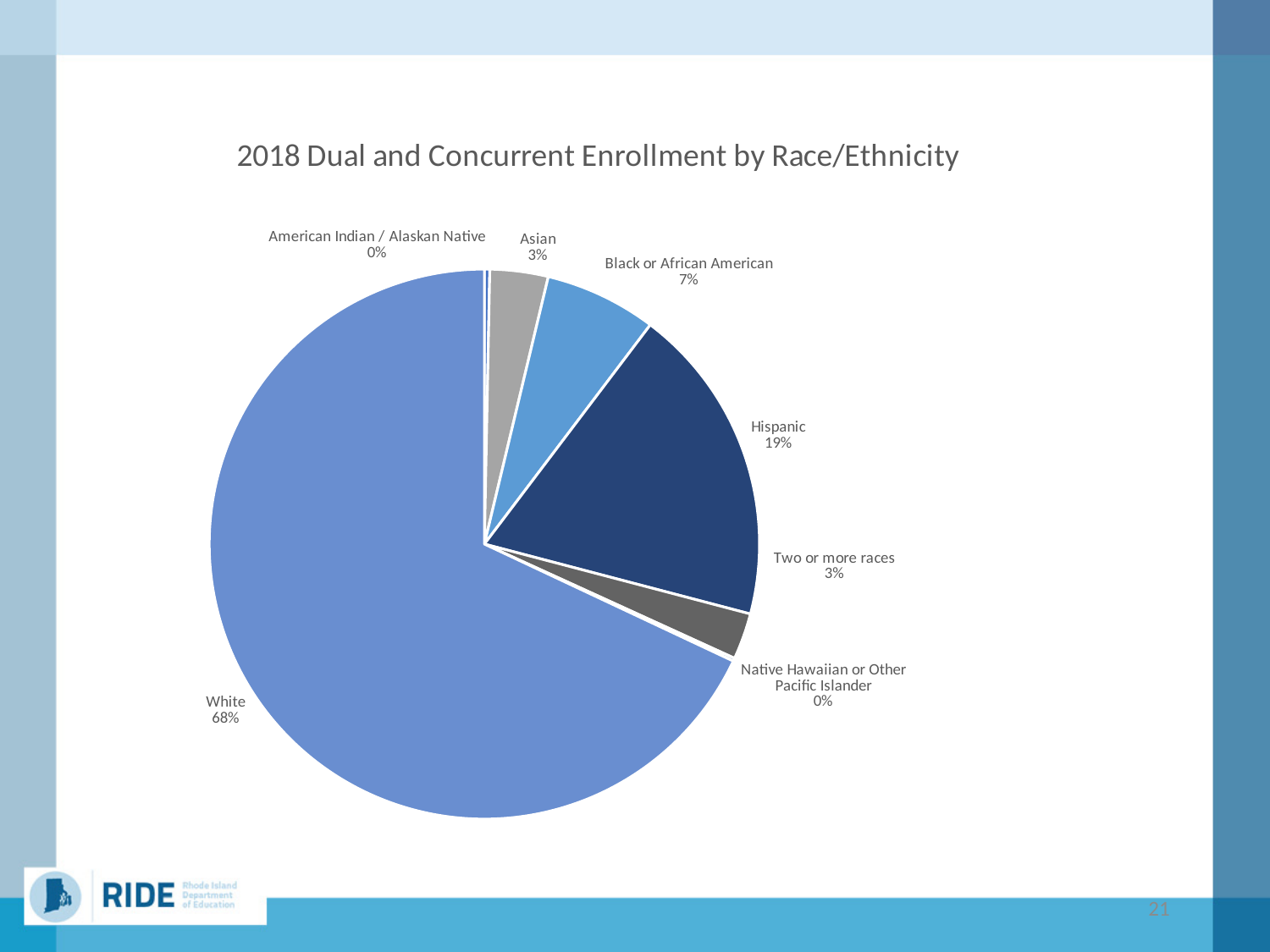
What is the value for Hispanic? 19% What is the value for Native Hawaiian or Other Pacific Islander? 0% Which is larger, the share for Hispanic or the share for Black or African American? Hispanic What kind of chart is shown on the slide? Pie chart What share of the pie does White represent? 68% How many categories are shown in the pie chart? 7 What is the difference between the White and Hispanic shares? 49% What is the value for Black or African American? 7% What is the value for Two or more races? 3% What is the title of the chart? 2018 Dual and Concurrent Enrollment by Race/Ethnicity What is the value for Asian? 3% Which category has the largest slice of the pie? White